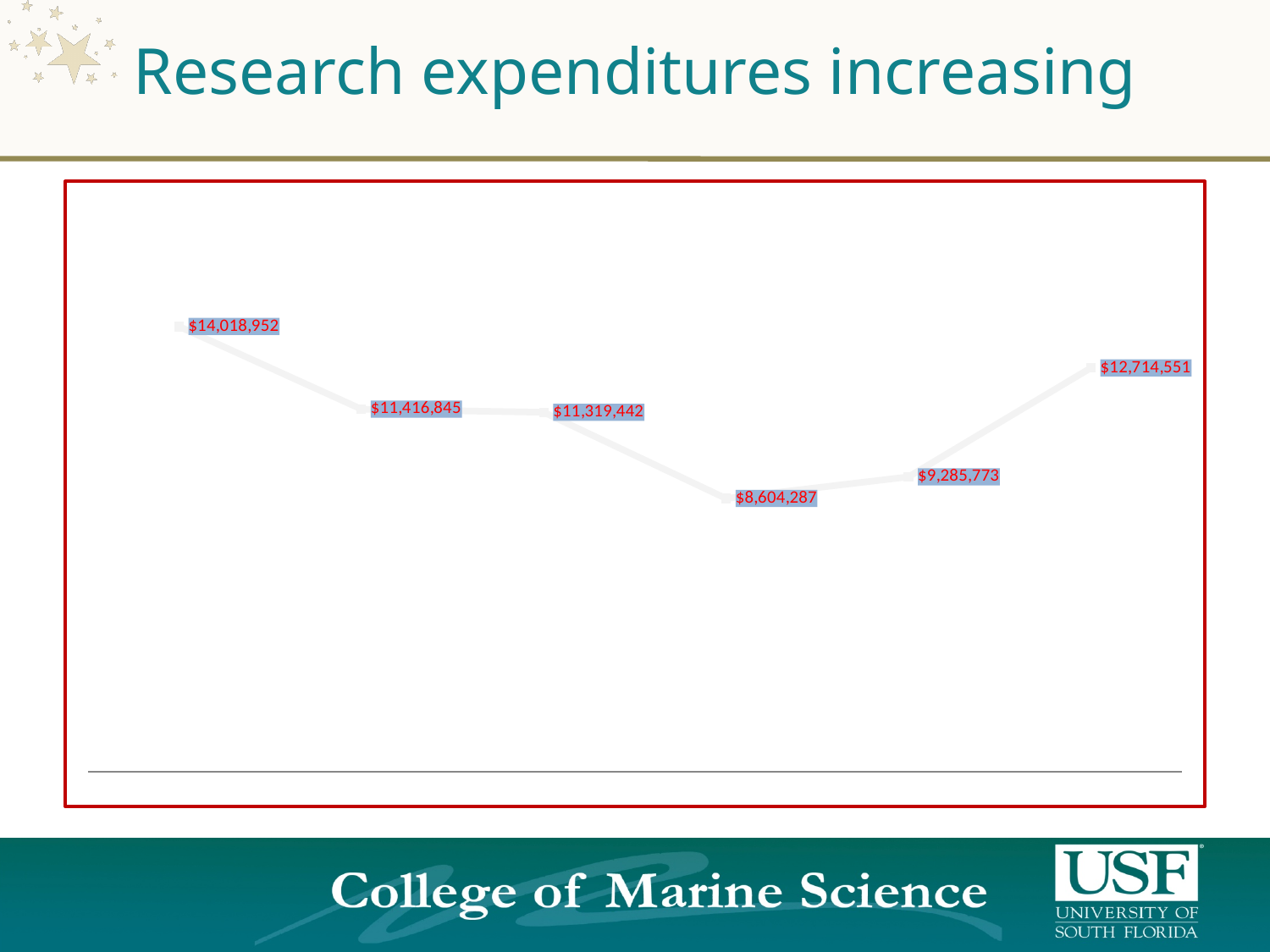
What is the difference between the first data point ($14,018,952) and the last data point ($12,714,551)? $1,304,401 What is the value of the last (rightmost) data point? $12,714,551 What is the value of the fourth data point from the left? $8,604,287 What is the lowest value plotted on the chart? $8,604,287 Which is larger, the second data point ($11,416,845) or the third data point ($11,319,442)? the second data point ($11,416,845) How many data points are plotted on the line? 6 Do the values rise or fall from the fourth data point to the last data point? rise What is the value of the fifth data point from the left? $9,285,773 What is the difference between the last data point ($12,714,551) and the lowest data point ($8,604,287)? $4,110,264 What is the highest value plotted on the chart? $14,018,952 What is the value of the first (leftmost) data point? $14,018,952 What kind of chart is shown on the slide? line chart